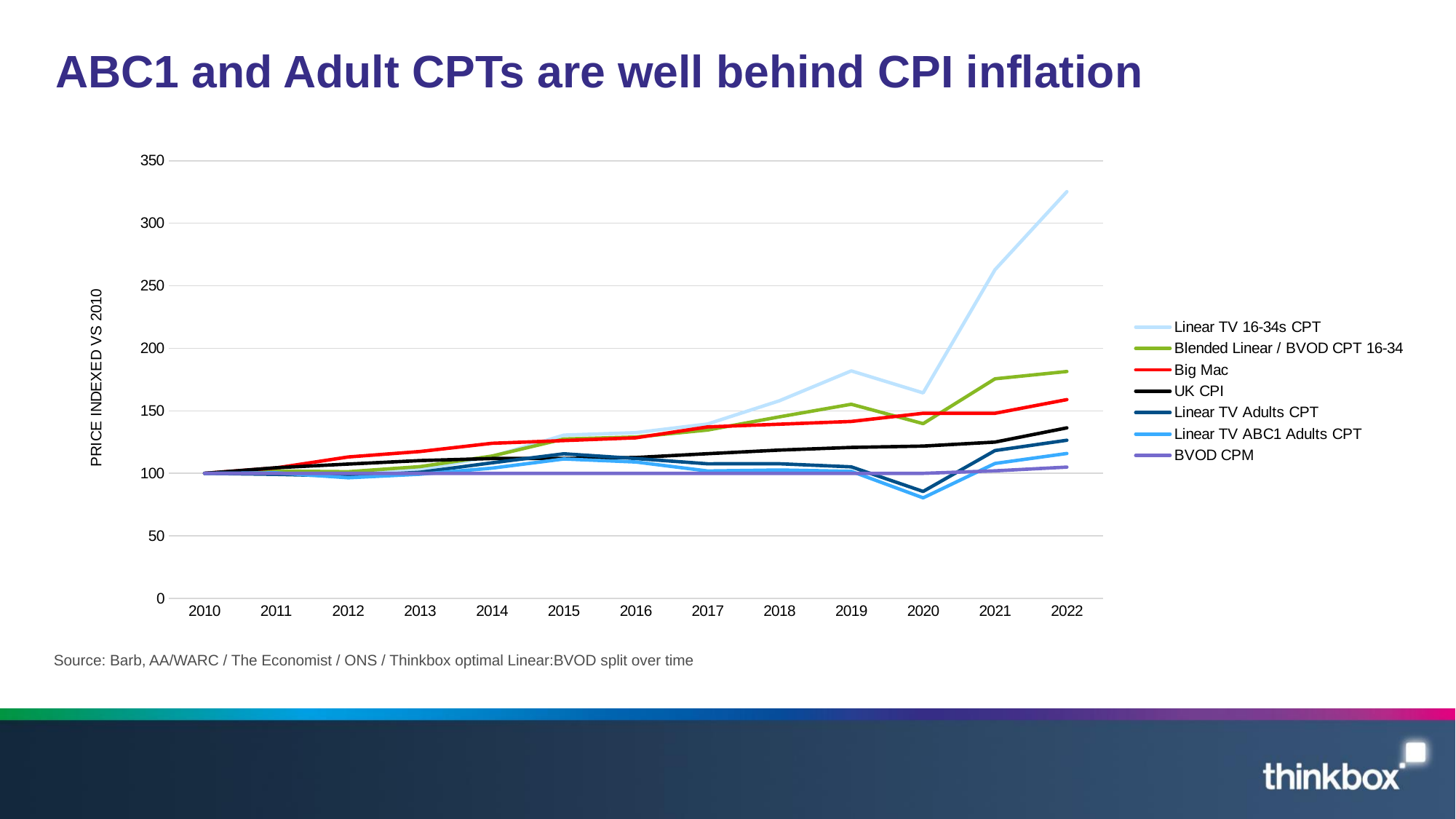
How many series does the legend list? 7 What kind of chart is shown on the slide? line chart What is the value of every series in 2010? 100 Which series has the lowest value in 2022? BVOD CPM Is the value for UK CPI in 2022 greater or less than 150? less How many years are shown along the x axis? 13 Which is larger in 2022, Big Mac or UK CPI? Big Mac Which series has the highest value in 2022? Linear TV 16-34s CPT Is the value for Linear TV 16-34s CPT in 2022 greater or less than 300? greater What is the label on the y axis? PRICE INDEXED VS 2010 Is the value for Linear TV ABC1 Adults CPT in 2020 greater or less than 100? less Does the Linear TV 16-34s CPT line generally rise or fall from 2010 to 2022? rise